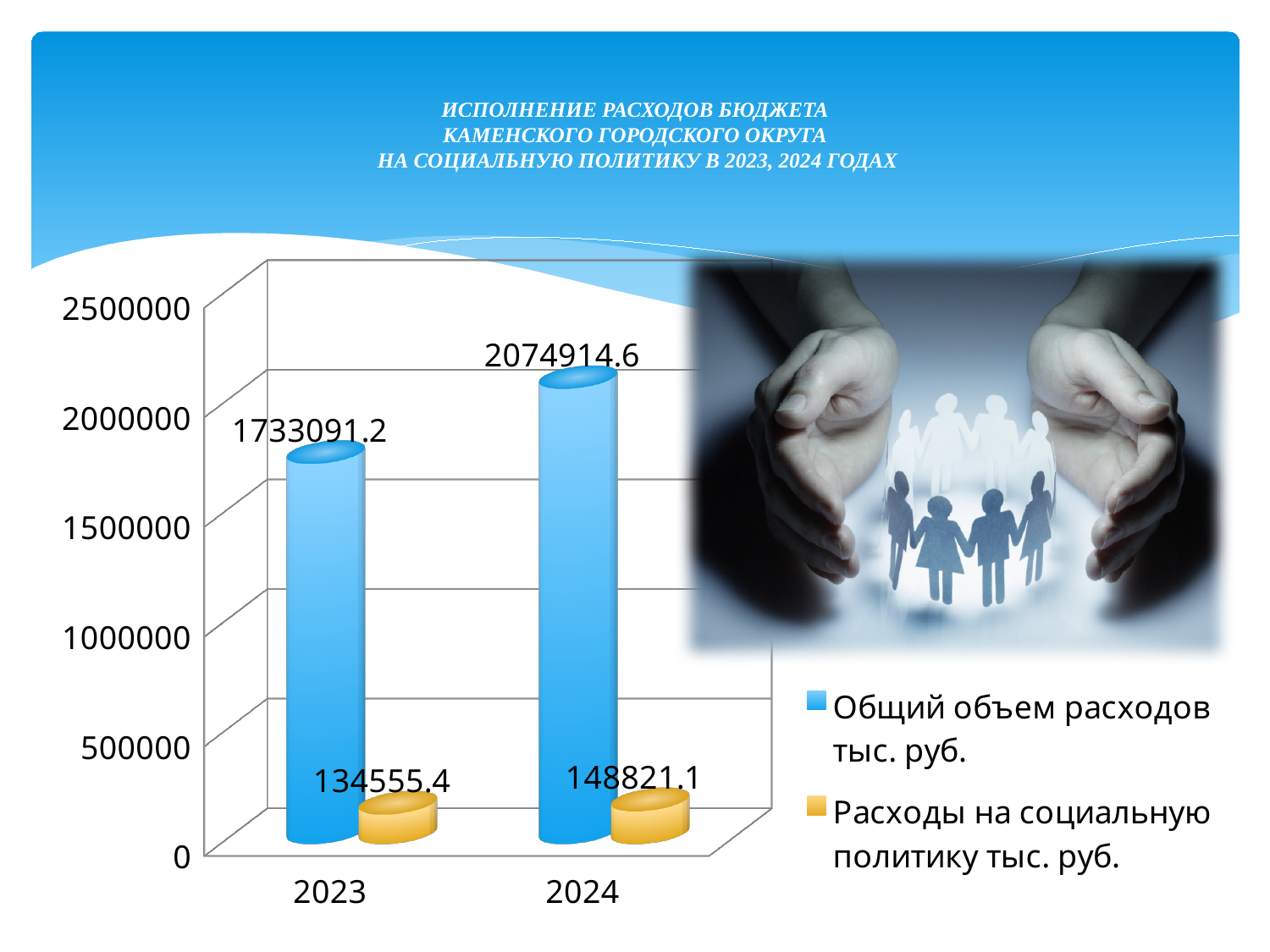
What is the value of 'Общий объем расходов тыс. руб.' for 2023? 1733091.2 What kind of chart is shown on the slide? bar chart Is the value of 'Общий объем расходов тыс. руб.' for 2024 greater or less than 2000000? greater By how much did 'Общий объем расходов тыс. руб.' increase from 2023 to 2024? 341823.4 What is the value of 'Расходы на социальную политику тыс. руб.' for 2024? 148821.1 What is the value of 'Общий объем расходов тыс. руб.' for 2024? 2074914.6 Which is larger: 'Общий объем расходов тыс. руб.' in 2023 or 'Расходы на социальную политику тыс. руб.' in 2024? Общий объем расходов тыс. руб. in 2023 How many series does the legend list? 2 In which year is 'Общий объем расходов тыс. руб.' highest? 2024 In which year is 'Расходы на социальную политику тыс. руб.' lowest? 2023 What is the value of 'Расходы на социальную политику тыс. руб.' for 2023? 134555.4 What is the difference between 'Расходы на социальную политику тыс. руб.' in 2024 and in 2023? 14265.7